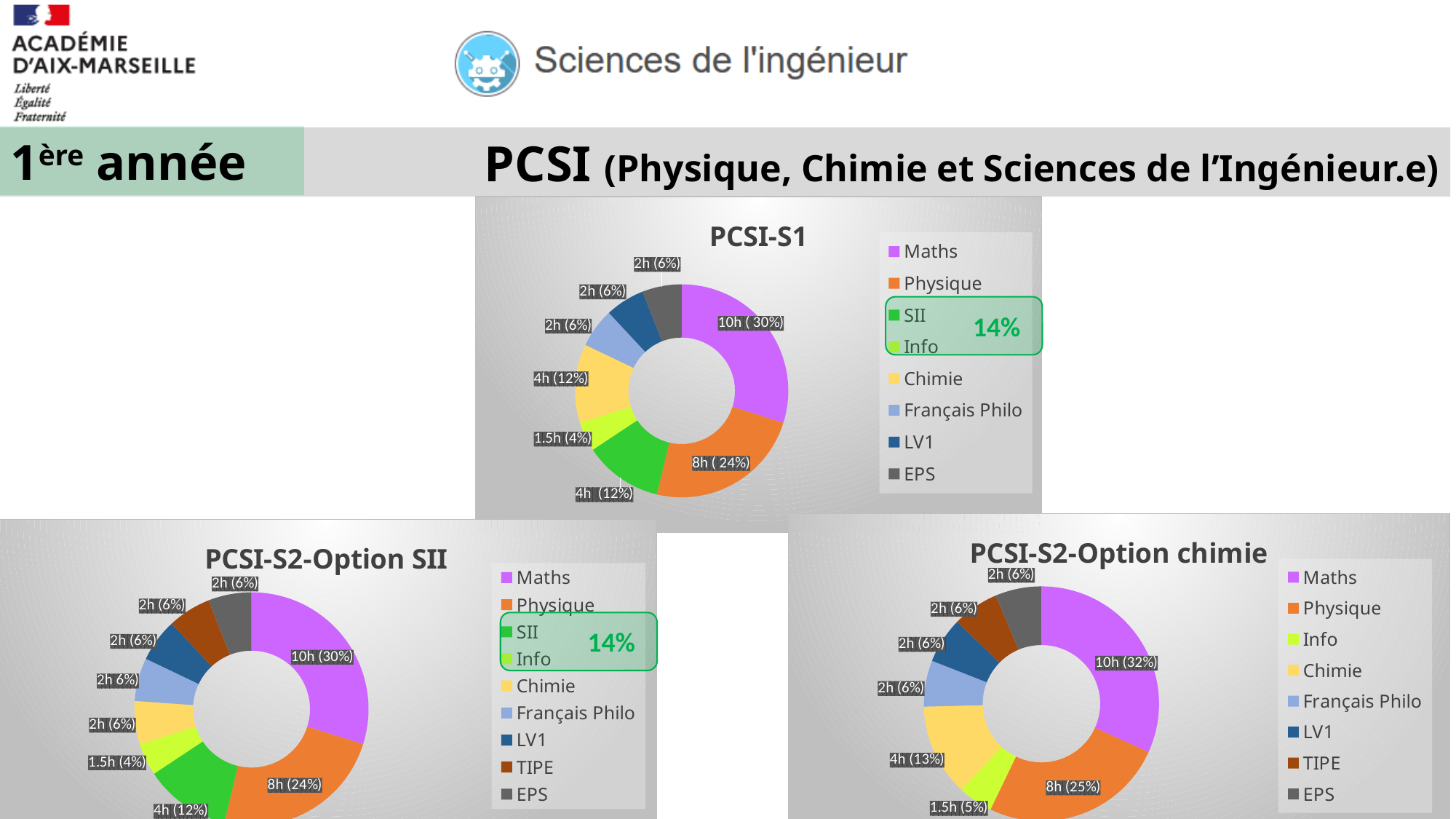
How many entries does the legend of the PCSI-S2-Option SII chart list? 9 In the PCSI-S1 chart, what is the value shown for Maths? 10h (30%) In the PCSI-S2-Option SII chart, what is the value shown for Chimie? 2h (6%) How many entries does the legend of the PCSI-S1 chart list? 8 In the PCSI-S1 chart, which subject has the smallest share? Info In the PCSI-S1 chart, which subject has the largest share? Maths In the PCSI-S1 chart, what is the value shown for Physique? 8h (24%) In the PCSI-S2-Option chimie chart, what is the value shown for Maths? 10h (32%) In the PCSI-S2-Option chimie chart, what is the value shown for Chimie? 4h (13%) In the PCSI-S2-Option chimie chart, what is the difference in hours between Maths and Physique? 2h What kind of chart is the PCSI-S2-Option SII chart? Pie chart (doughnut) In the PCSI-S2-Option chimie chart, which is larger, Physique or Chimie? Physique